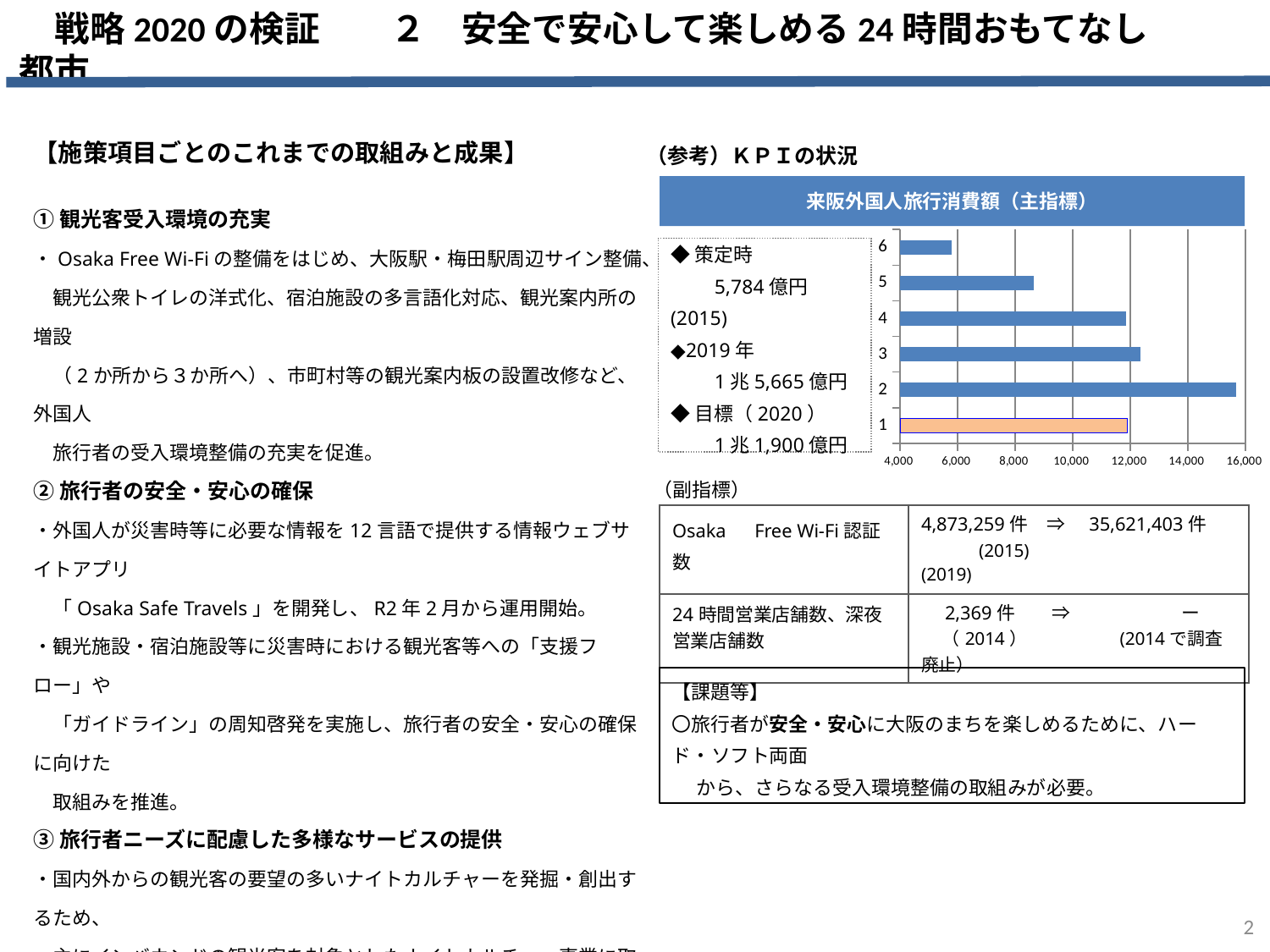
Which category's bar is drawn in a different colour (orange) from the others? 1 What kind of chart is shown on the slide? bar chart Which has the larger value, category 5 or category 6? category 5 Is the value for category 2 greater or less than 14,000? greater Is the value for category 6 greater or less than 8,000? less Is the value for category 3 greater or less than 10,000? greater What is the title of the chart? 来阪外国人旅行消費額（主指標） Which category has the shortest bar? 6 How many categories (bars) does the chart show? 6 Which category has the longest bar? 2 Which has the larger value, category 2 or category 5? category 2